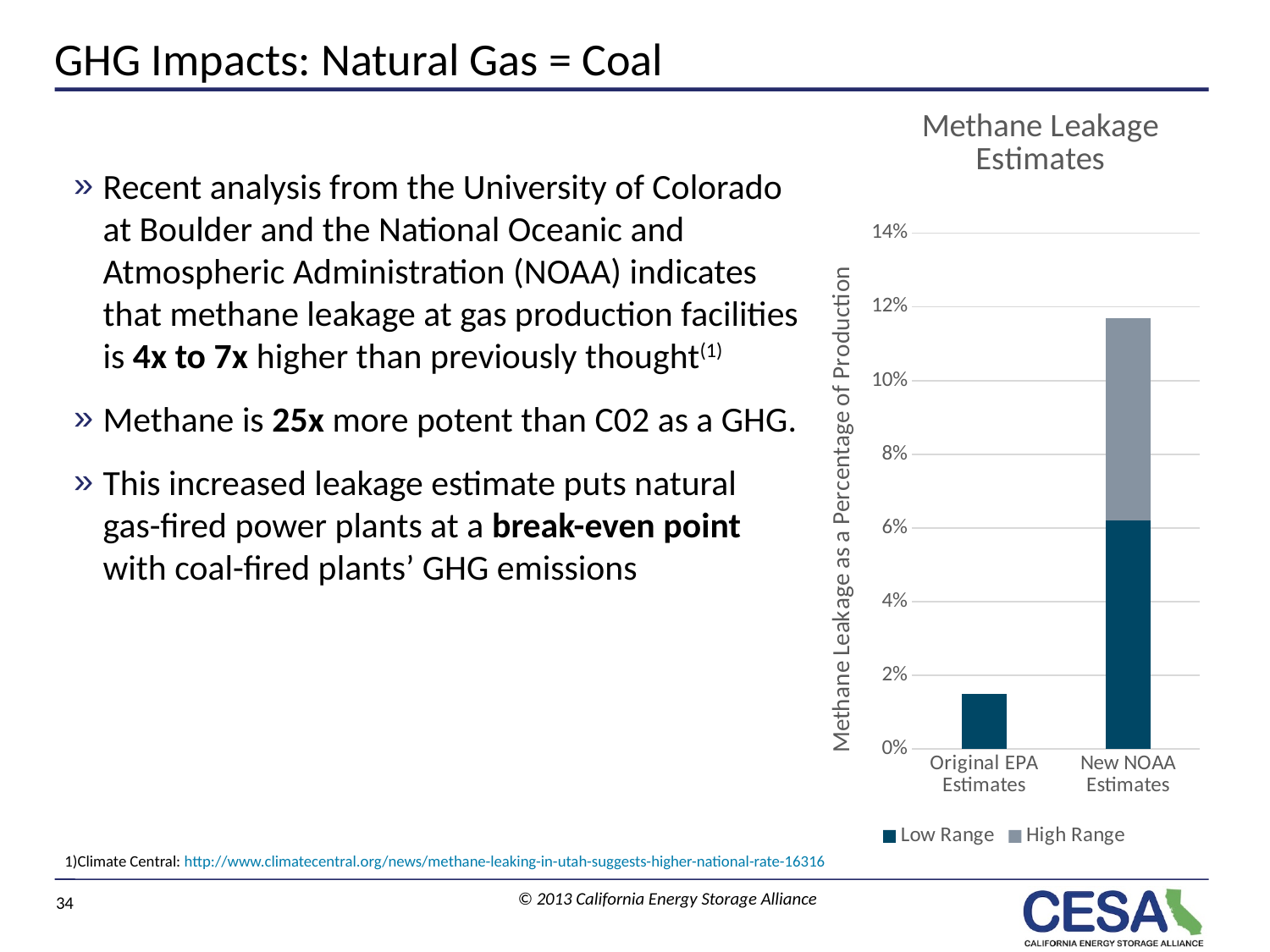
What is the title of the chart? Methane Leakage Estimates How many categories are shown on the x axis of the chart? 2 Is the value for Original EPA Estimates greater or less than 2%? less Do the bar heights rise or fall from Original EPA Estimates to New NOAA Estimates? rise Which category has the taller bar in the chart? New NOAA Estimates How many series does the chart legend list? 2 Which category has the shorter bar in the chart? Original EPA Estimates Is the Low Range value for New NOAA Estimates greater or less than 4%? greater Which is larger: the Low Range value for Original EPA Estimates or the Low Range value for New NOAA Estimates? New NOAA Estimates What are the two series named in the chart legend? Low Range and High Range Is the total height of the New NOAA Estimates bar greater or less than 10%? greater What type of chart is shown on the slide? Stacked bar chart